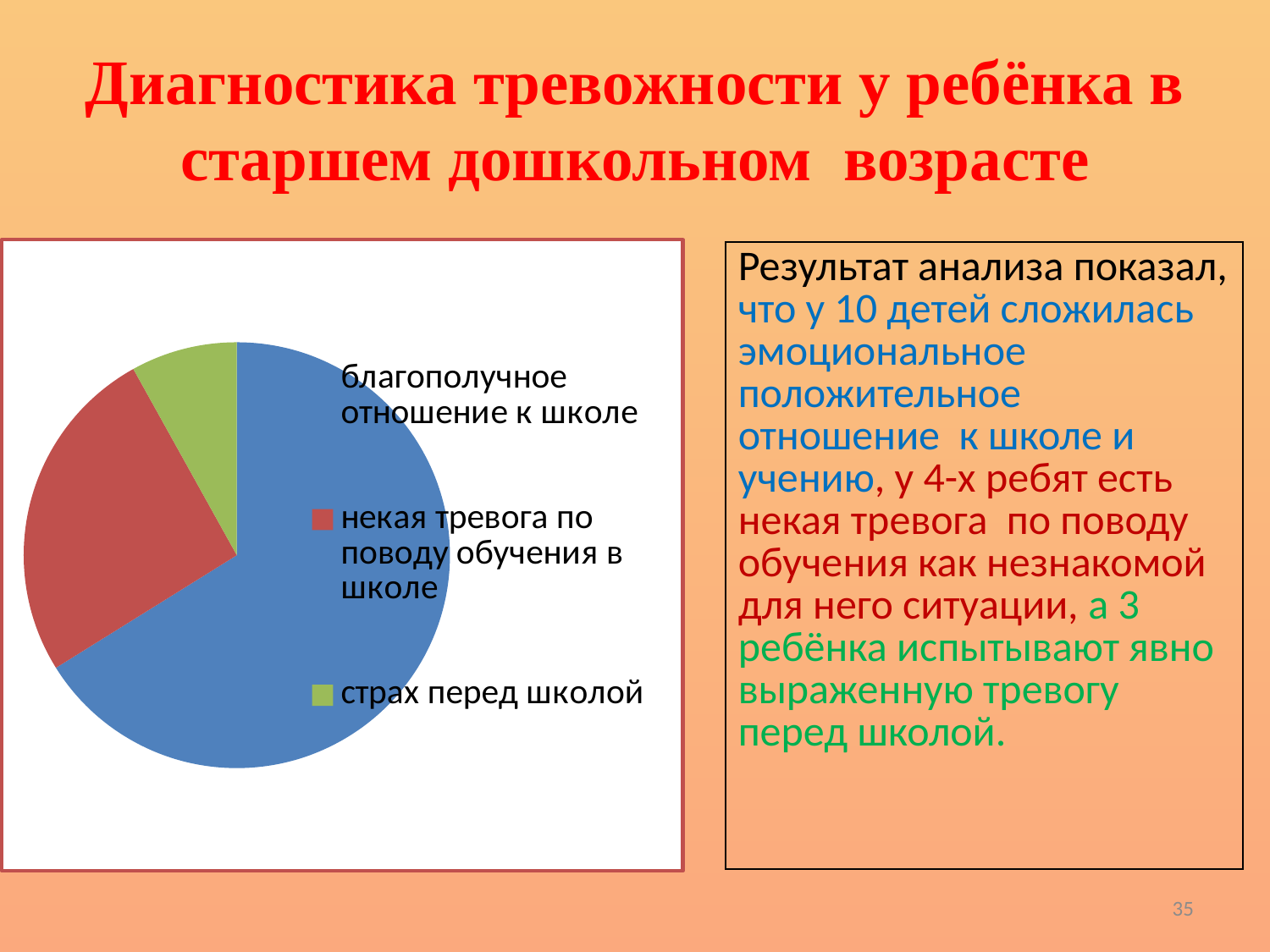
Which category has the smallest slice in the pie chart? страх перед школой How many entries does the legend of the pie chart list? 3 What colour is the slice for "страх перед школой" in the pie chart? green Which slice is larger: "некая тревога по поводу обучения в школе" or "страх перед школой"? некая тревога по поводу обучения в школе Does the slice for "благополучное отношение к школе" take up more or less than half of the pie? more Which slice is larger: "благополучное отношение к школе" or "некая тревога по поводу обучения в школе"? благополучное отношение к школе Which category has the largest slice in the pie chart? благополучное отношение к школе Which category is shown in blue in the pie chart? благополучное отношение к школе What kind of chart is shown on the slide? pie chart How many slices does the pie chart have? 3